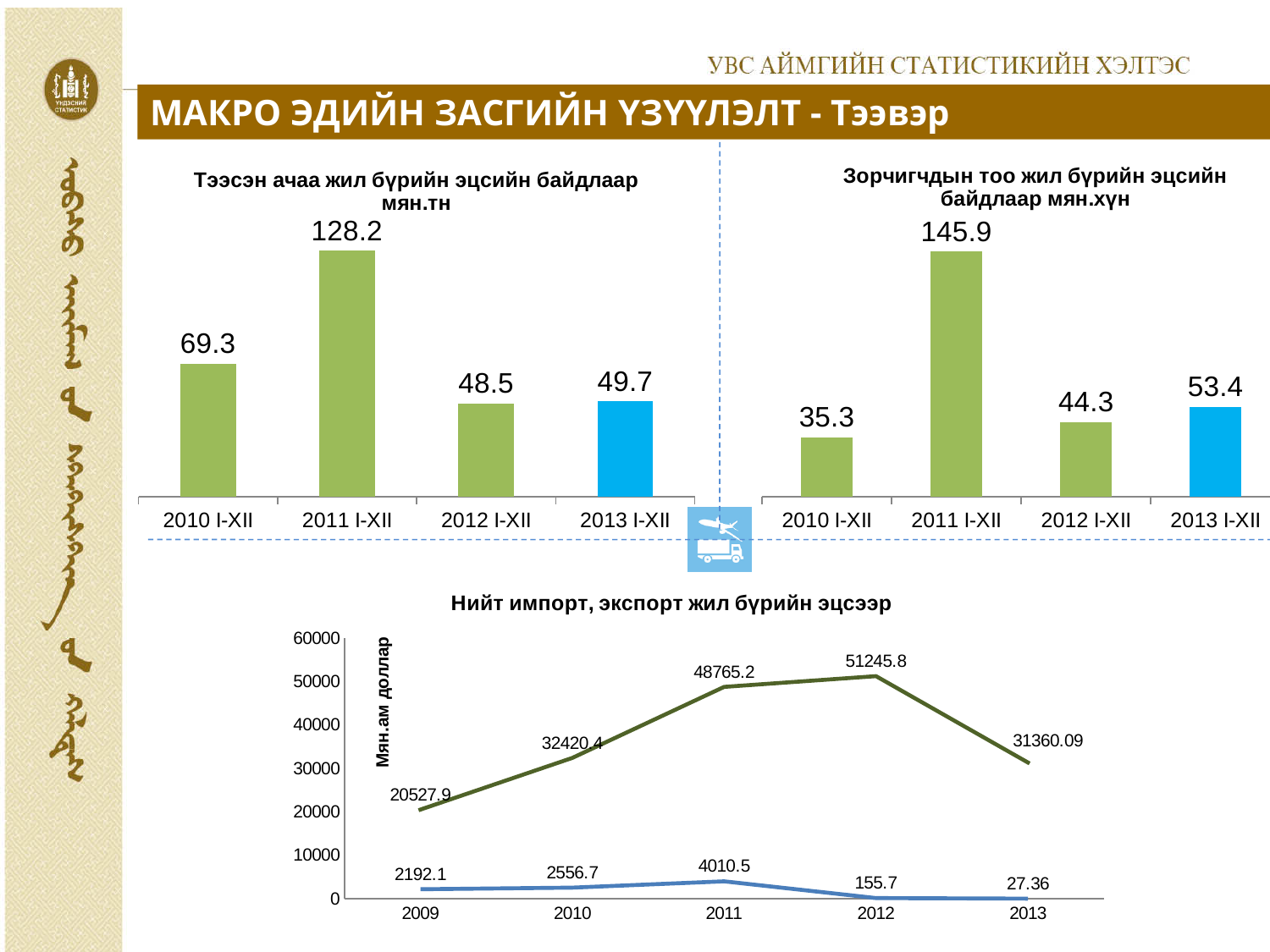
In the chart titled 'Нийт импорт, экспорт жил бүрийн эцсээр', what is the value of the lower line in 2011? 4010.5 In the chart titled 'Зорчигчдын тоо жил бүрийн эцсийн байдлаар мян.хүн', what is the value for 2013 I-XII? 53.4 In the chart titled 'Нийт импорт, экспорт жил бүрийн эцсээр', what is the value of the upper line in 2012? 51245.8 In the chart titled 'Тээсэн ачаа жил бүрийн эцсийн байдлаар мян.тн', what is the value for 2011 I-XII? 128.2 In the chart titled 'Зорчигчдын тоо жил бүрийн эцсийн байдлаар мян.хүн', which is larger, the value for 2012 I-XII or 2013 I-XII? 2013 I-XII In the chart titled 'Нийт импорт, экспорт жил бүрийн эцсээр', in which year does the upper line reach its highest value? 2012 What kind of chart is the chart titled 'Зорчигчдын тоо жил бүрийн эцсийн байдлаар мян.хүн'? Bar chart In the chart titled 'Зорчигчдын тоо жил бүрийн эцсийн байдлаар мян.хүн', which year has the highest value? 2011 I-XII In the chart titled 'Тээсэн ачаа жил бүрийн эцсийн байдлаар мян.тн', how many bars are shown? 4 In the chart titled 'Тээсэн ачаа жил бүрийн эцсийн байдлаар мян.тн', what is the difference between the 2011 I-XII and 2010 I-XII values? 58.9 What is the y-axis label of the chart titled 'Нийт импорт, экспорт жил бүрийн эцсээр'? Мян.ам доллар In the chart titled 'Тээсэн ачаа жил бүрийн эцсийн байдлаар мян.тн', which year has the lowest value? 2012 I-XII